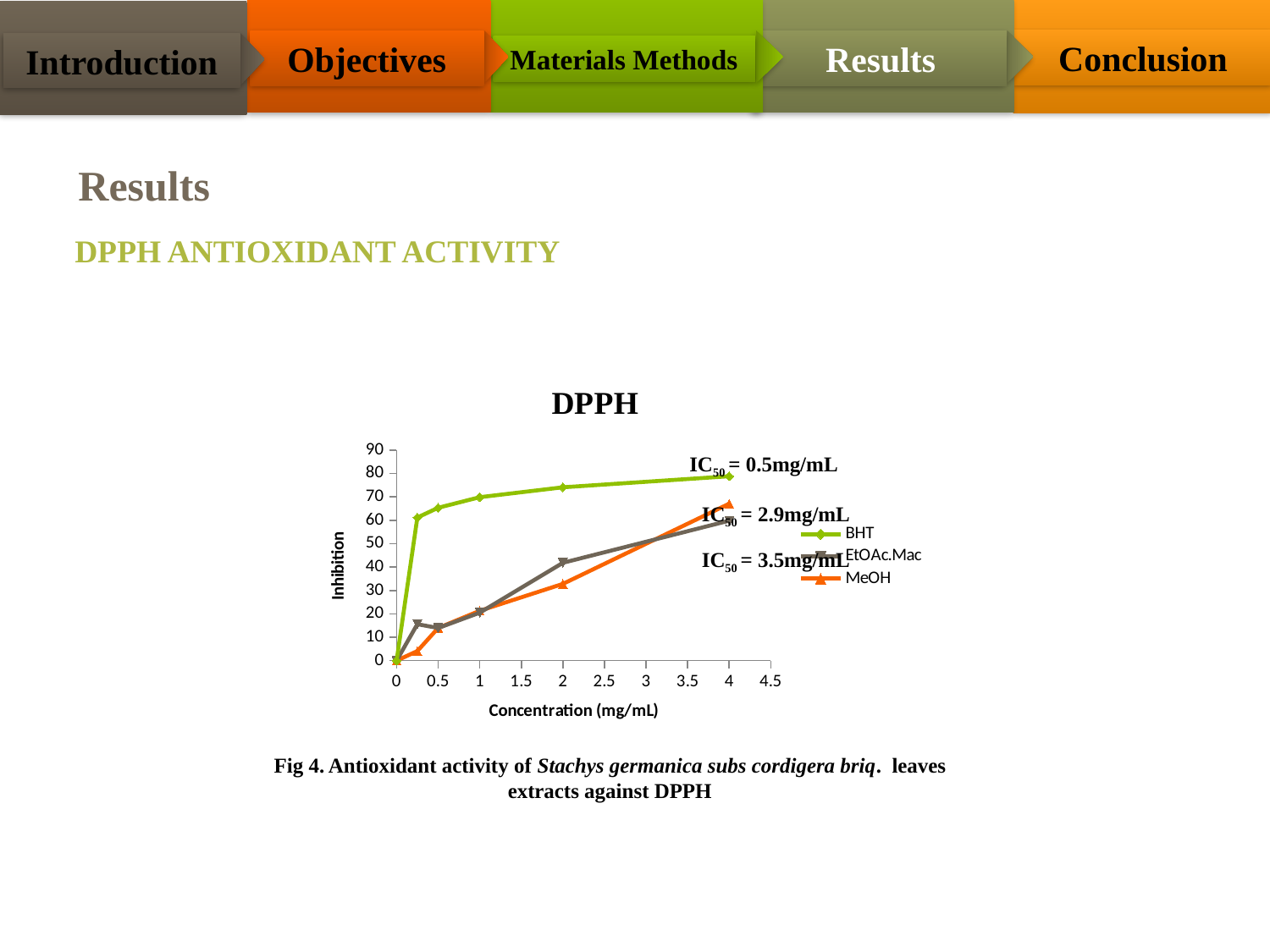
What is the title of the x axis of the DPPH chart? Concentration (mg/mL) Is the inhibition value for BHT at 4 mg/mL greater or less than 70? greater Is the inhibition value for MeOH at 0.5 mg/mL greater or less than 20? less Which series has the highest inhibition at a concentration of 4 mg/mL in the DPPH chart? BHT Is the inhibition value for MeOH at 4 mg/mL greater or less than 60? greater What kind of chart is the DPPH chart? line chart Does the inhibition for BHT rise or fall as concentration increases along the x axis? rise At a concentration of 2 mg/mL, which series has the larger inhibition, EtOAc.Mac or MeOH? EtOAc.Mac How many series does the legend of the DPPH chart list? 3 What IC50 value is annotated next to the BHT line in the DPPH chart? 0.5mg/mL